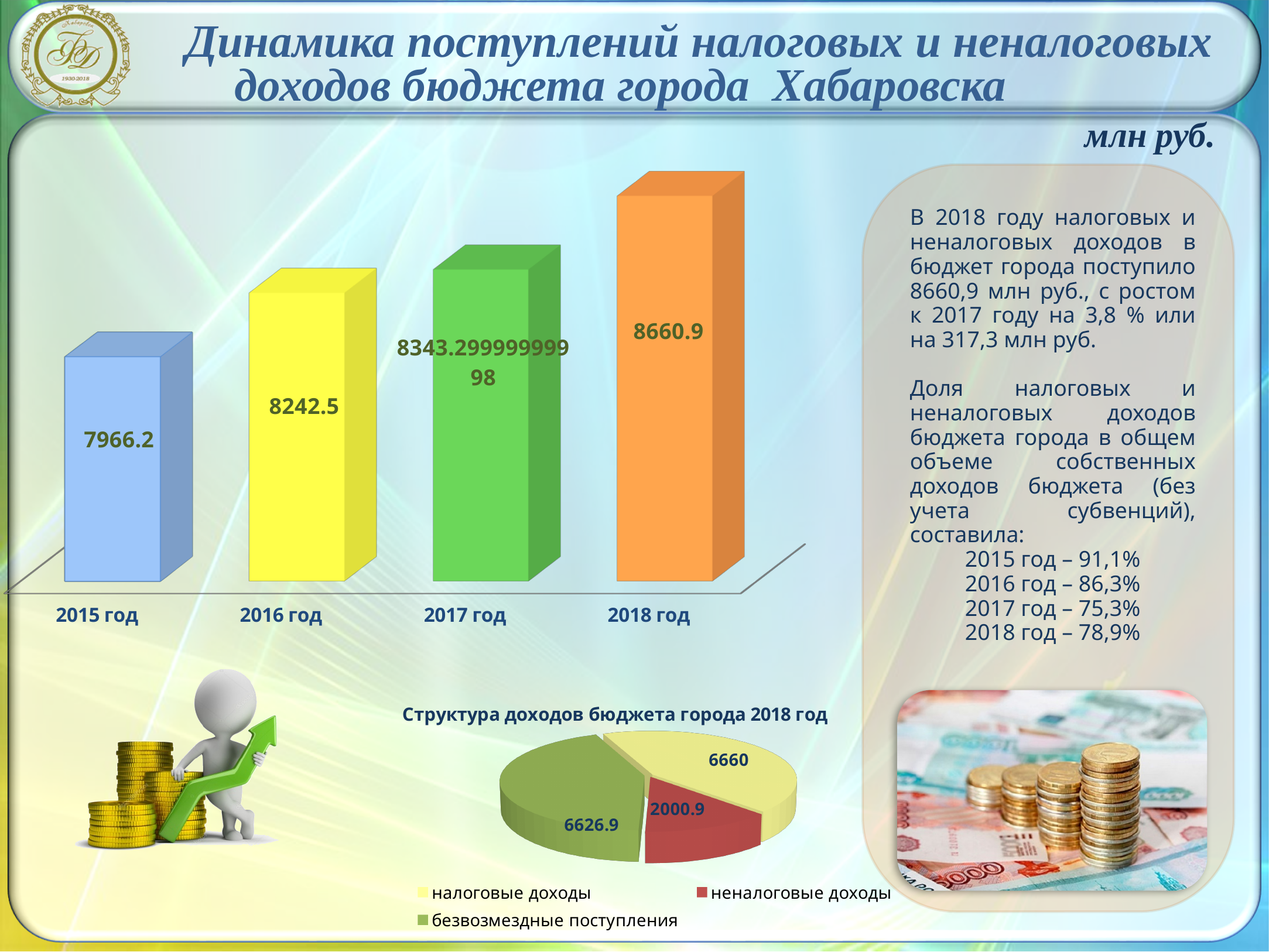
On the bar chart at the top of the slide, what is the difference between the values for 2018 год and 2015 год? 694.7 How many entries does the legend of the pie chart 'Структура доходов бюджета города 2018 год' list? 3 On the bar chart at the top of the slide, what is the value for 2018 год? 8660.9 How many years are shown on the bar chart at the top of the slide? 4 On the bar chart at the top of the slide, what value is printed on the bar for 2017 год? 8343.29999999998 On the bar chart at the top of the slide, what is the value for 2015 год? 7966.2 On the bar chart at the top of the slide, do the values rise or fall from 2015 год to 2018 год? rise On the pie chart 'Структура доходов бюджета города 2018 год', what is the value for неналоговые доходы? 2000.9 On the bar chart at the top of the slide, which year has the lowest value? 2015 год What kind of chart is the chart at the top of the slide? bar chart On the bar chart at the top of the slide, which year has the highest value? 2018 год On the pie chart 'Структура доходов бюджета города 2018 год', which category has the smallest slice? неналоговые доходы